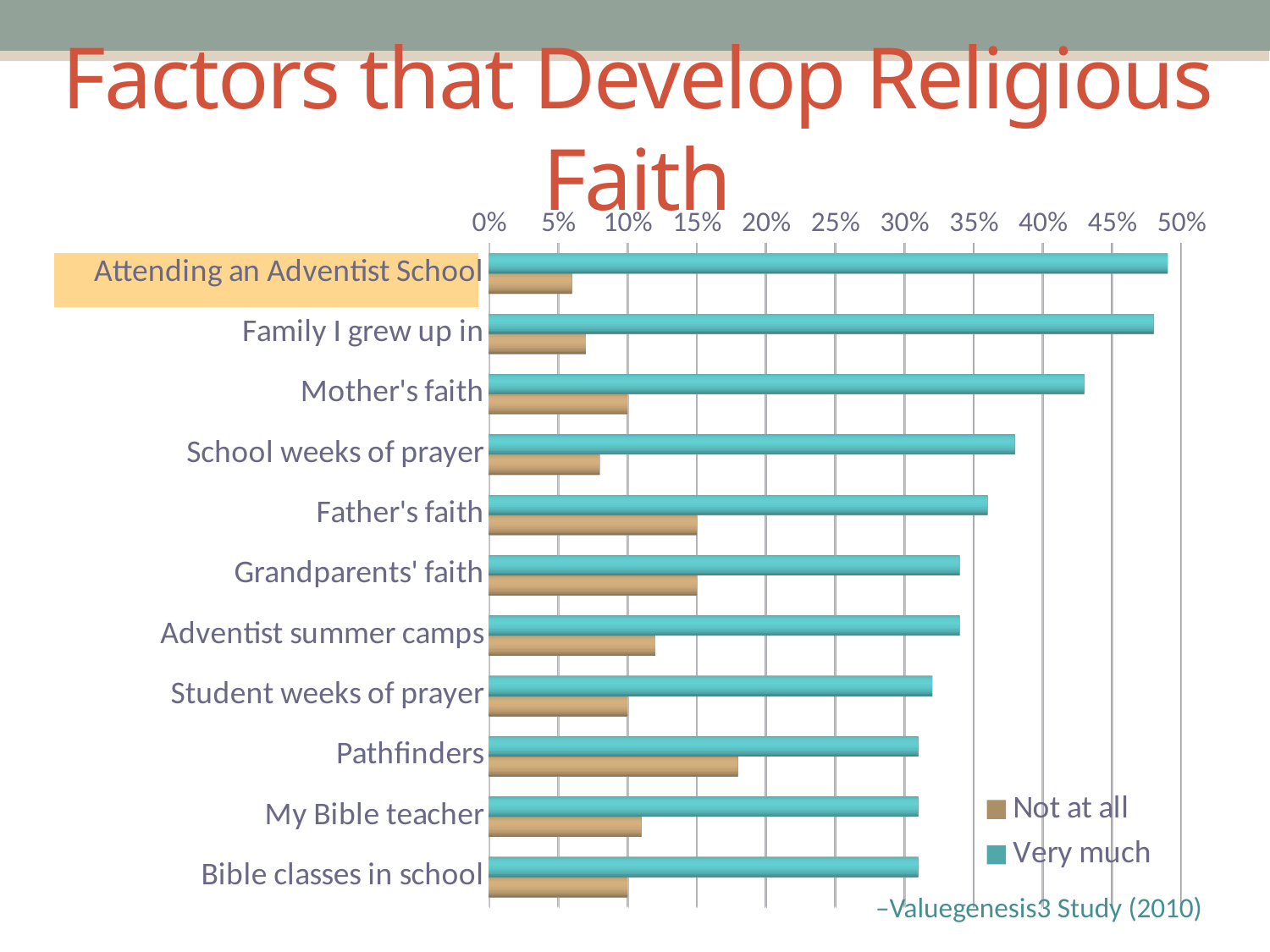
Is the 'Not at all' value for Attending an Adventist School greater or less than 10%? less Which has a larger 'Very much' value: Mother's faith or School weeks of prayer? Mother's faith Which has a larger 'Not at all' value: Pathfinders or My Bible teacher? Pathfinders What kind of chart is shown on the slide? Bar chart What source is cited below the chart? Valuegenesis3 Study (2010) Which factor has the highest 'Not at all' value? Pathfinders Is the 'Very much' value for Mother's faith greater or less than 40%? greater Do the 'Very much' bars get longer or shorter going down the list of factors? shorter Is the 'Not at all' value for Father's faith greater or less than 10%? greater How many series does the legend list? 2 How many factors (categories) are listed on the chart? 11